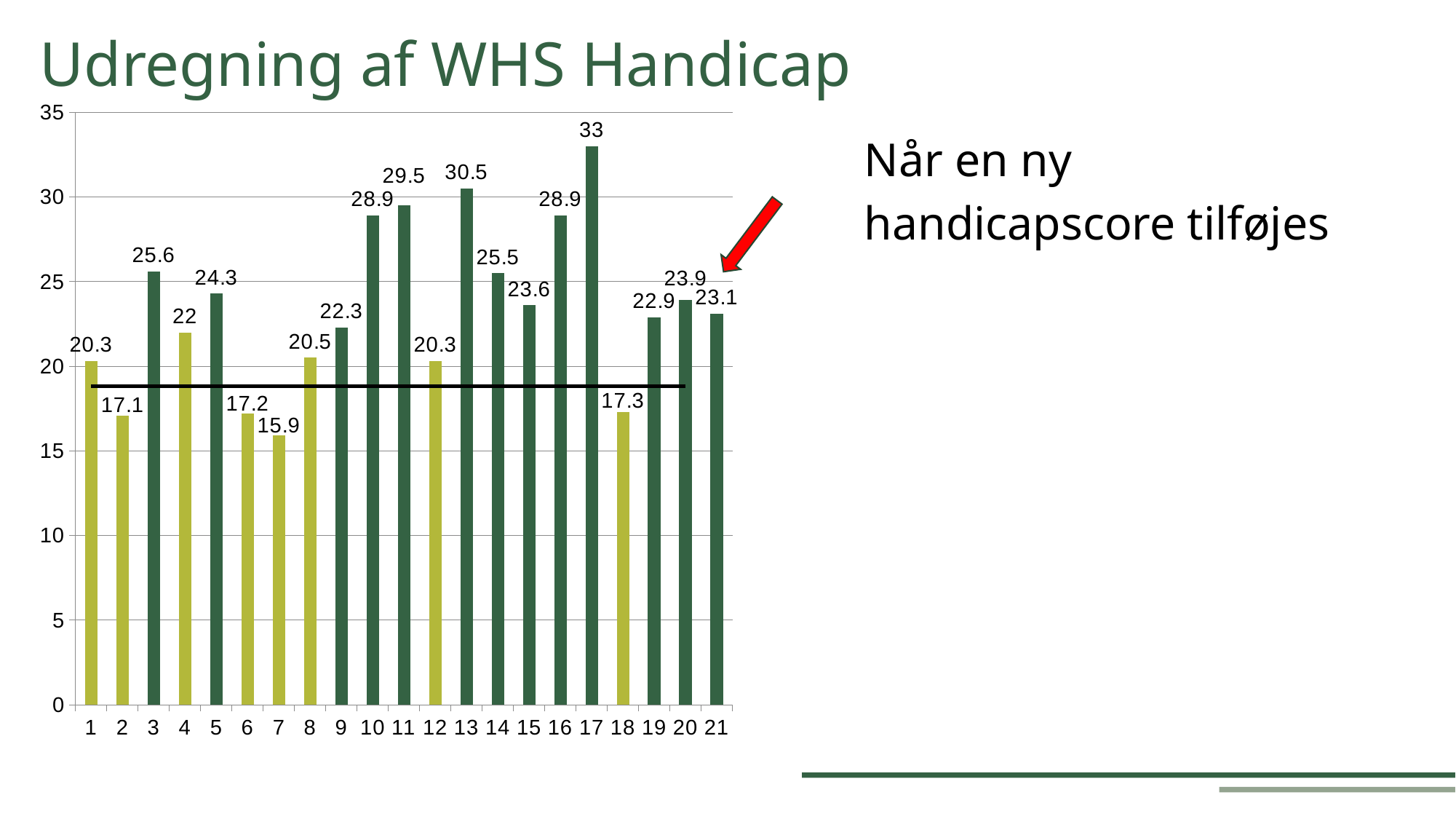
What kind of chart is shown on the slide? Bar chart What is the value for category 7? 15.9 Which category has the highest value? 17 What is the value for category 17? 33 What is the value for category 11? 29.5 How many bars are coloured light green rather than dark green? 8 What is the difference between the values for category 13 and category 3? 4.9 Which category has the lowest value? 7 What is the difference between the values for category 17 and category 7? 17.1 How many categories are shown on the x axis? 21 Which is larger, the value for category 10 or the value for category 14? Category 10 What is the value for category 20? 23.9